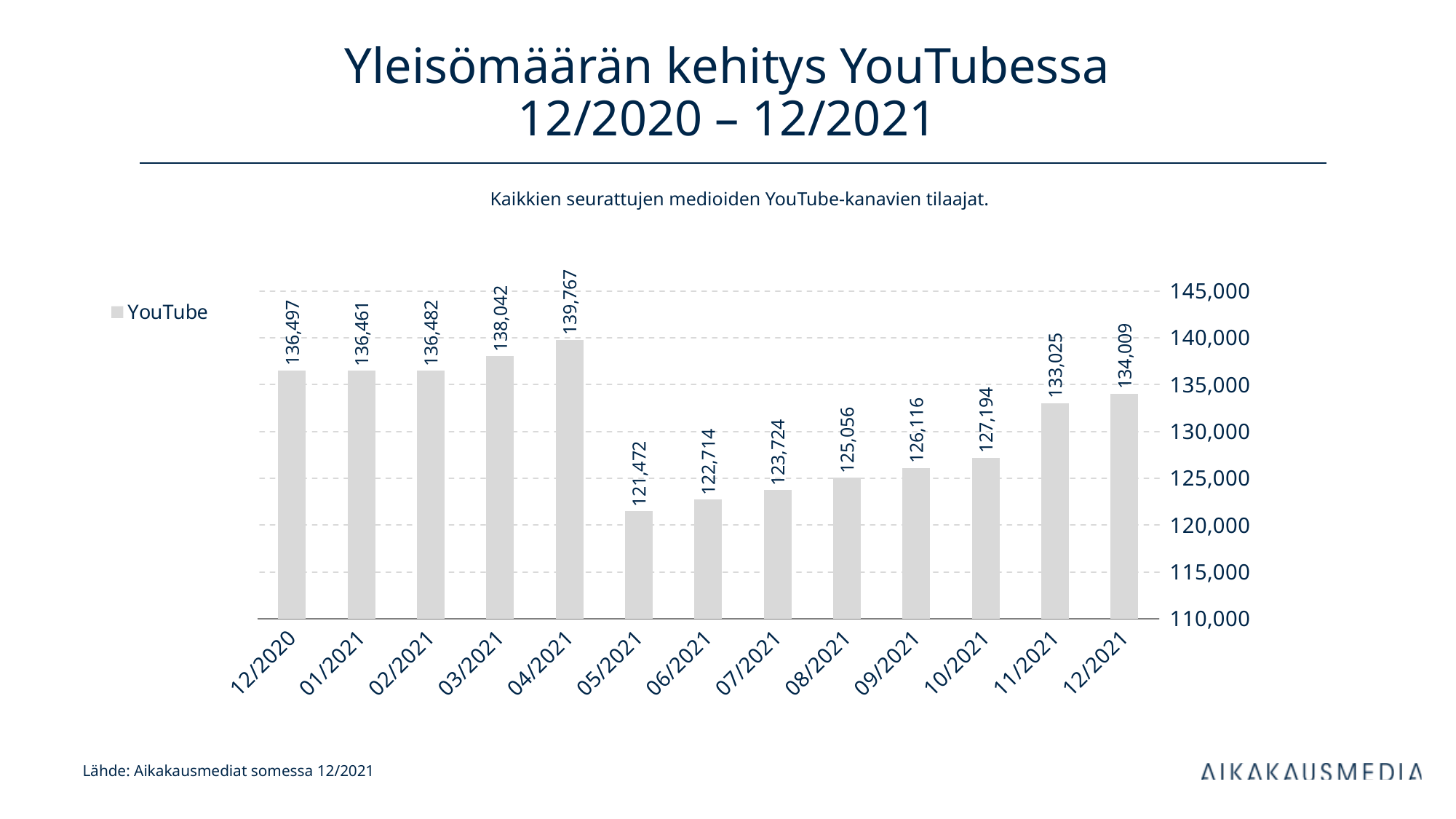
Which month has the highest value? 04/2021 What is the difference between the values for 04/2021 and 05/2021? 18,295 What kind of chart is shown on the slide? bar chart What is the difference between the values for 12/2020 and 12/2021? 2,488 How many months are shown on the x axis? 13 What is the value for 04/2021? 139,767 Is the value for 05/2021 greater or less than 125,000? less What is the value for 12/2020? 136,497 Which month has the lowest value? 05/2021 What is the value for 05/2021? 121,472 Which is larger, the value for 03/2021 or the value for 11/2021? 03/2021 How many series does the legend list? 1